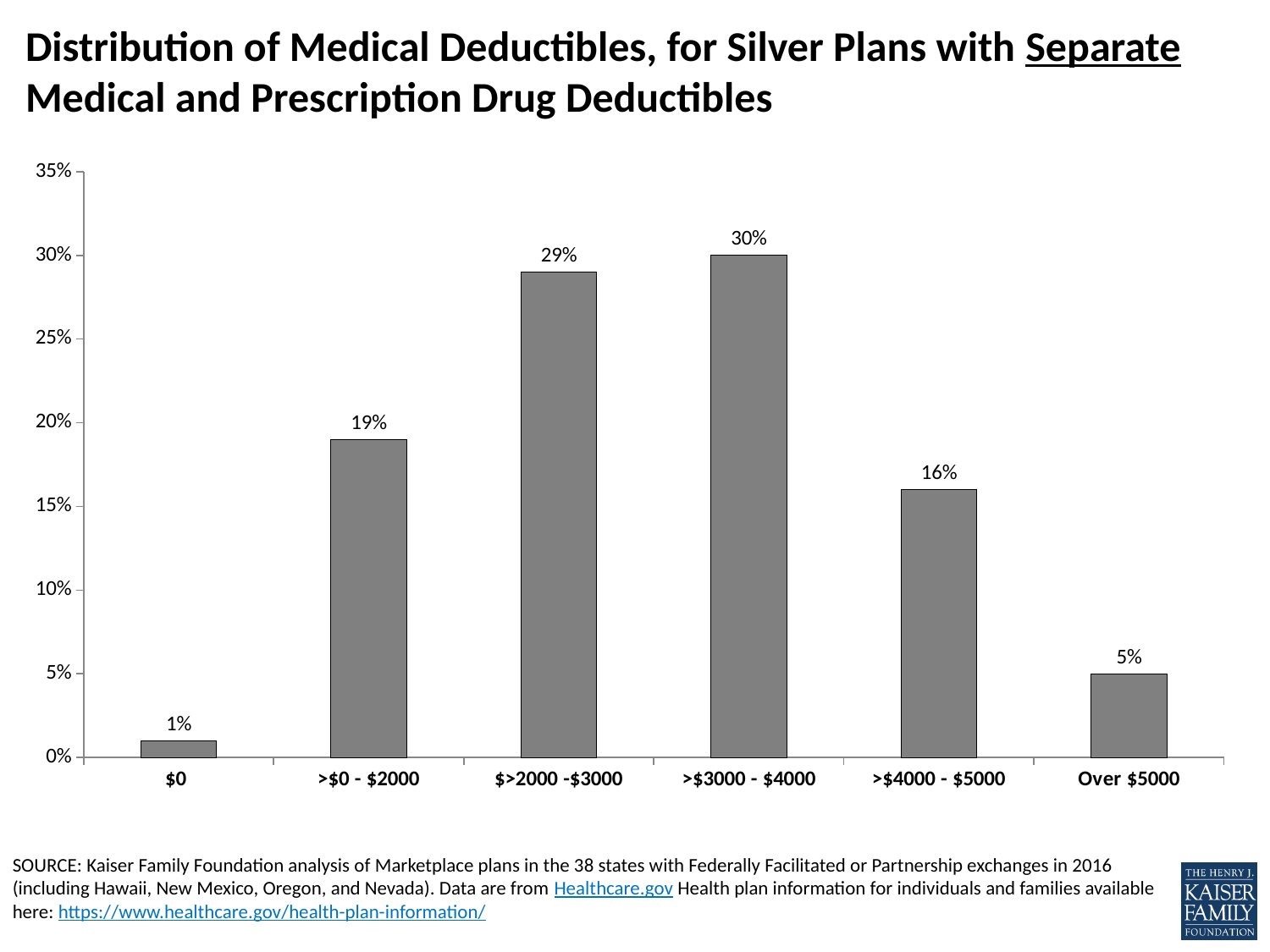
What is the difference between the >$0 - $2000 category and the >$4000 - $5000 category? 3% What is the value for the $0 deductible category? 1% What percentage of plans have a deductible of Over $5000? 5% Which deductible category has the highest share of plans? >$3000 - $4000 Which is larger: the value for >$0 - $2000 or the value for Over $5000? >$0 - $2000 What kind of chart is shown on the slide? Bar chart What is the combined share of plans in the $>2000 -$3000 and >$3000 - $4000 categories? 59% Is the value for $>2000 -$3000 greater or less than 25%? greater What is the maximum value shown on the y axis? 35% Which deductible category has the lowest share of plans? $0 What percentage of plans have a medical deductible of >$3000 - $4000? 30% How many deductible categories are shown on the x axis? 6